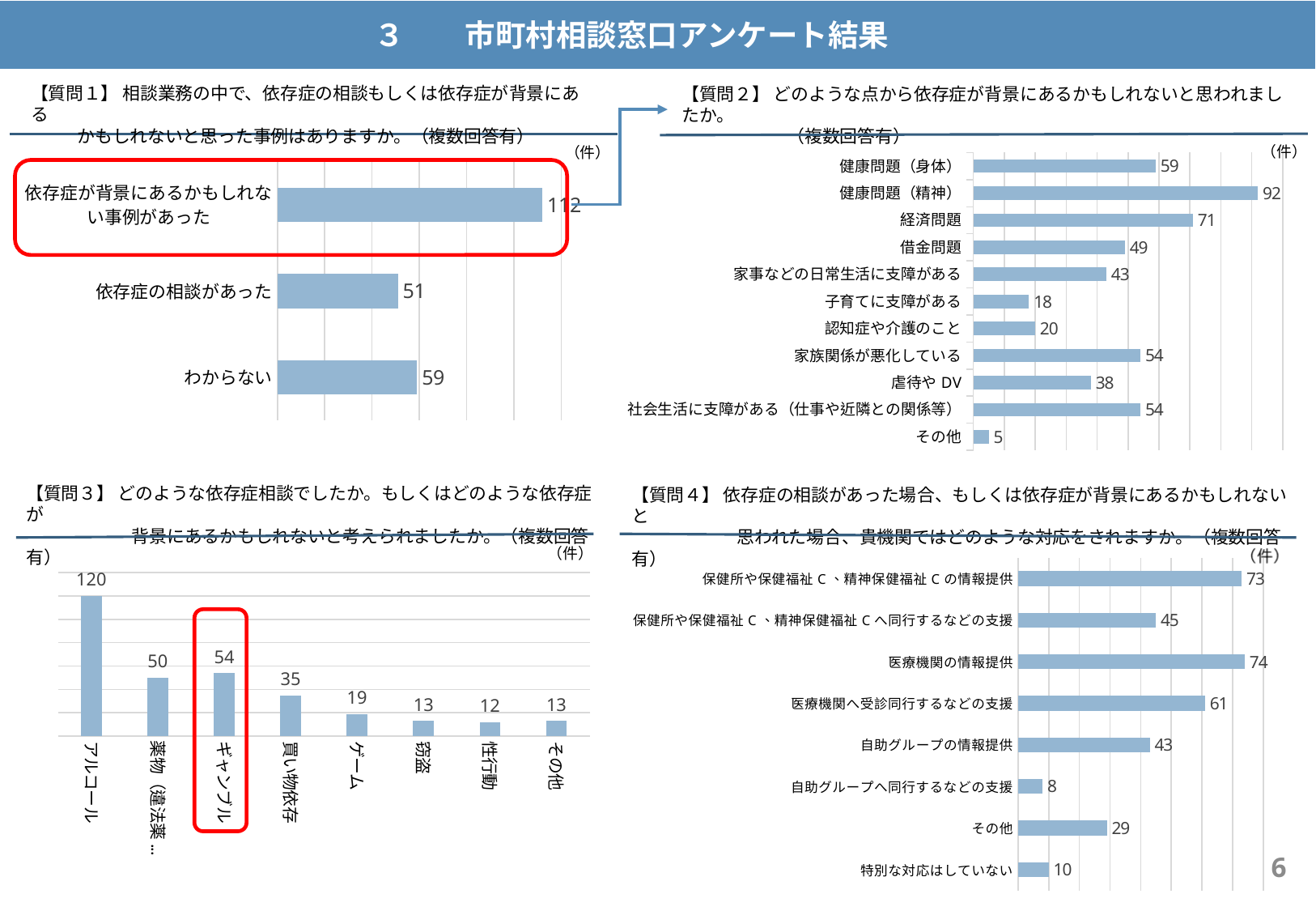
In the 質問4 chart (bottom-right), what is the value for 医療機関の情報提供? 74 In the 質問2 chart (top-right), what is the difference between 健康問題（精神） and 健康問題（身体）? 33 In the 質問3 chart (bottom-left), which category has the highest value? アルコール In the 質問1 chart (top-left), what is the value for 依存症が背景にあるかもしれない事例があった? 112 In the 質問1 chart (top-left), how many categories are shown? 3 In the 質問4 chart (bottom-right), which category has the lowest value? 自助グループへ同行するなどの支援 In the 質問2 chart (top-right), which category has the lowest value? その他 What type of chart is the 質問3 chart (bottom-left)? Bar chart In the 質問3 chart (bottom-left), which is larger, 薬物 or 買い物依存? 薬物 In the 質問2 chart (top-right), what is the value for 借金問題? 49 In the 質問3 chart (bottom-left), what is the value for ギャンブル? 54 In the 質問2 chart (top-right), which category has the highest value? 健康問題（精神）